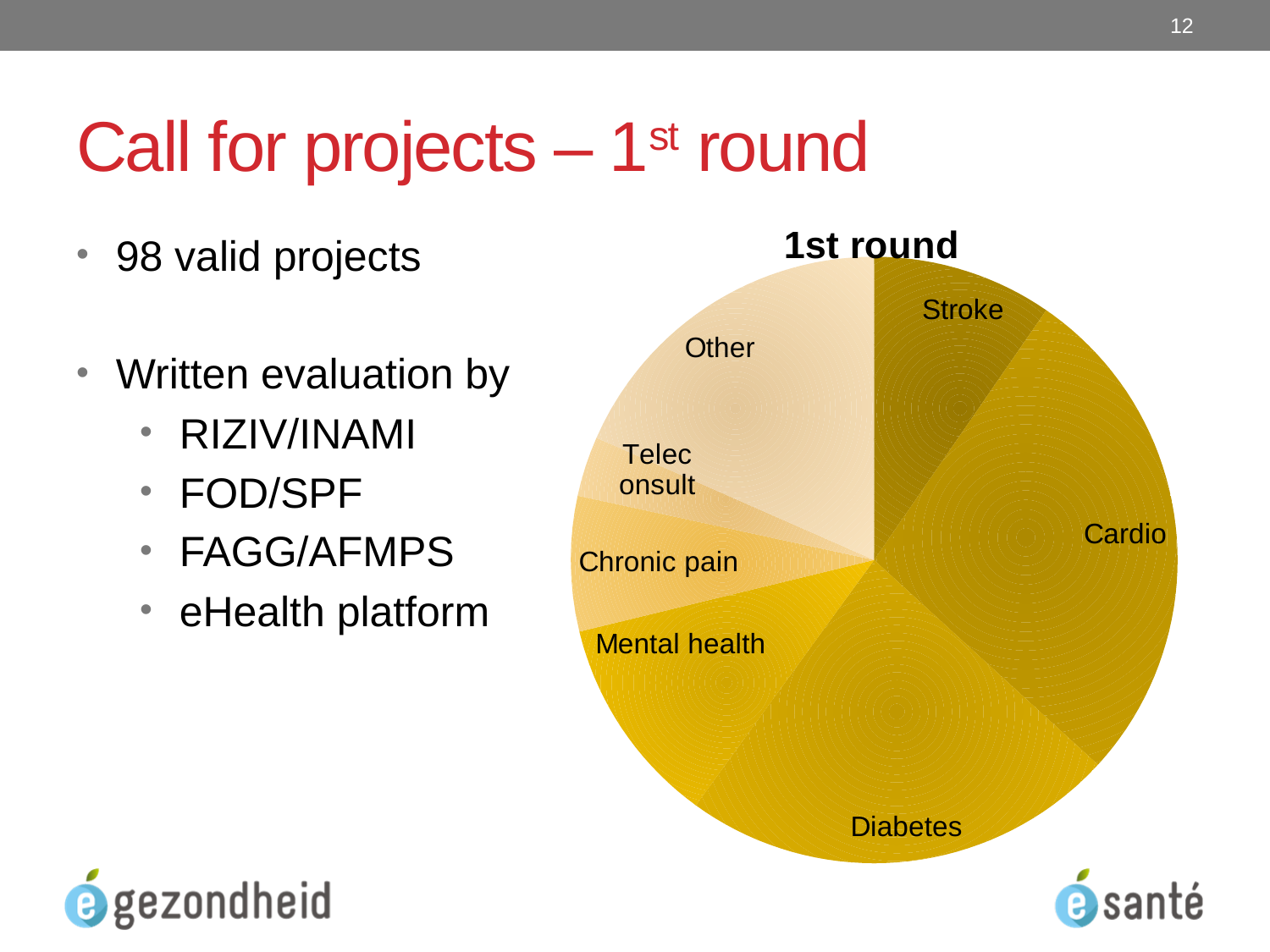
What is the title of the pie chart? 1st round Which slice is larger, Other or Chronic pain? Other Which slice is larger, Mental health or Teleconsult? Mental health Which slice is larger, Other or Teleconsult? Other Which category has the smallest slice of the pie chart? Teleconsult How many slices does the pie chart have? 7 What kind of chart is shown on the slide? pie chart Which category has the largest slice of the pie chart? Cardio